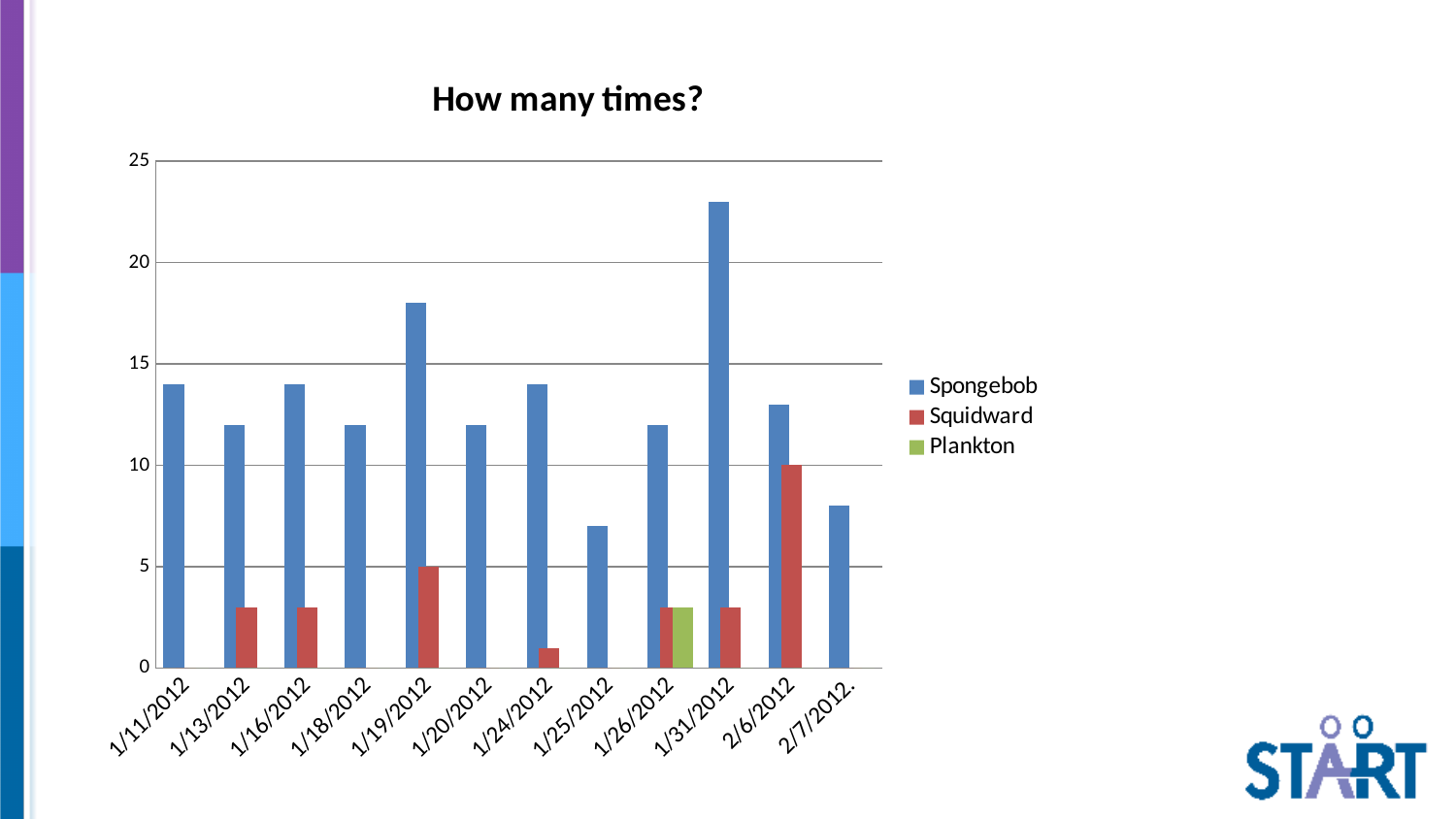
On which date is the Squidward value highest? 2/6/2012 Which is larger, the Spongebob value on 1/19/2012 or on 1/20/2012? 1/19/2012 What type of chart is shown on the slide? bar chart Which colour represents Plankton in the legend? green Is the value for Spongebob on 1/25/2012 greater or less than 10? less What is the value for Squidward on 1/19/2012? 5 Is the value for Spongebob on 1/31/2012 greater or less than 20? greater How many dates are shown along the x axis? 12 How many series does the legend list? 3 What is the title of the chart? How many times? On which date is the Spongebob value highest? 1/31/2012 What is the value for Squidward on 2/6/2012? 10